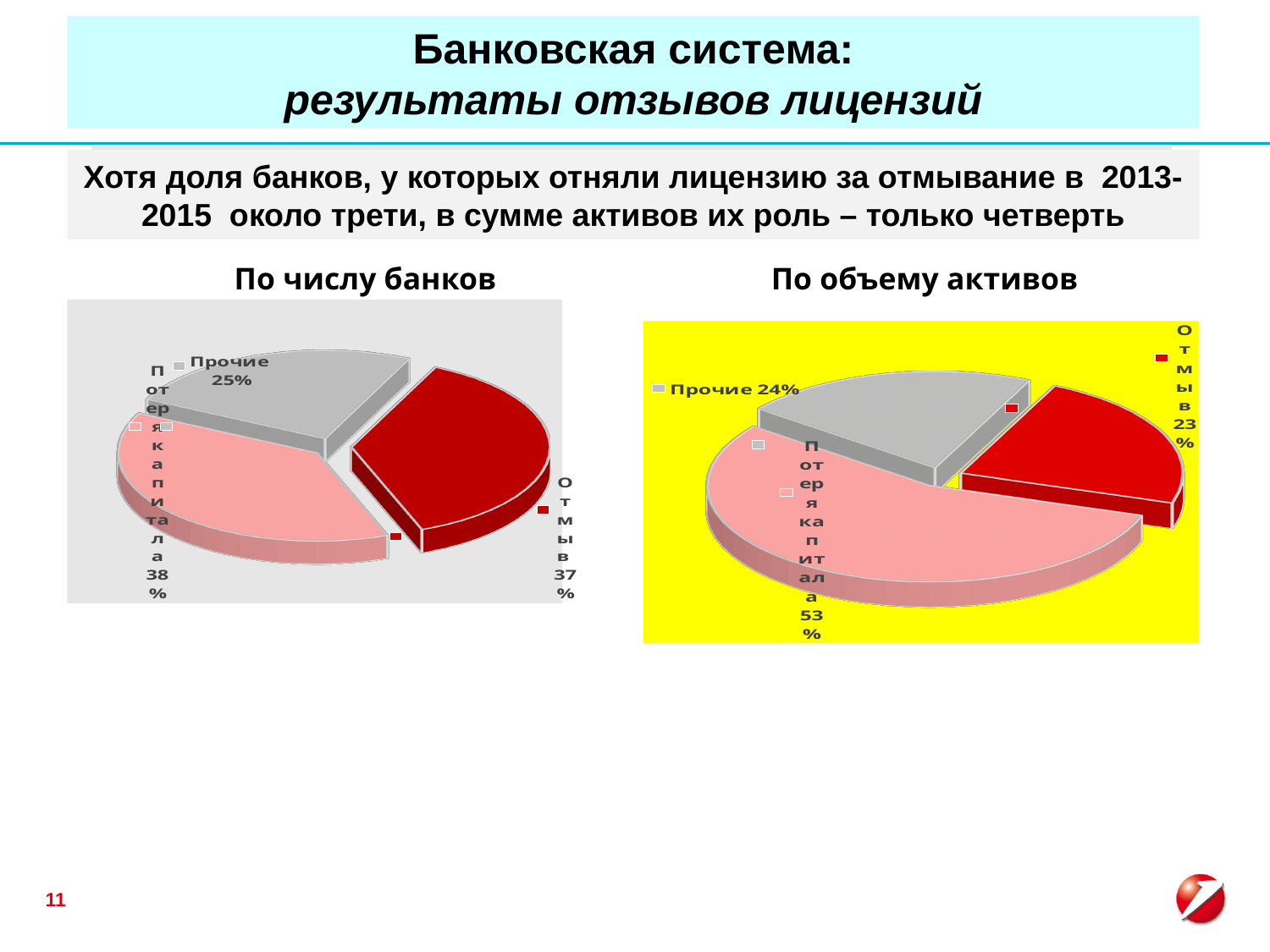
In the chart 'По объему активов', what share is labelled for 'Отмывы'? 23% In the chart 'По объему активов', which category has the largest share? Потеря капитала In the chart 'По числу банков', which category has the smallest share? Прочие In the chart 'По числу банков', what share is labelled for 'Прочие'? 25% What is the difference between the 'Отмывы' share in 'По числу банков' and in 'По объему активов'? 14 percentage points In the chart 'По объему активов', what is the difference between the 'Потеря капитала' share and the 'Прочие' share? 29 percentage points In the chart 'По числу банков', what share is labelled for 'Потеря капитала'? 38% In the chart 'По числу банков', what share is labelled for 'Отмывы'? 37% What type of chart is 'По объему активов'? Pie chart How many slices does the chart 'По числу банков' have? 3 In the chart 'По объему активов', what share is labelled for 'Прочие'? 24% In the chart 'По объему активов', what share is labelled for 'Потеря капитала'? 53%